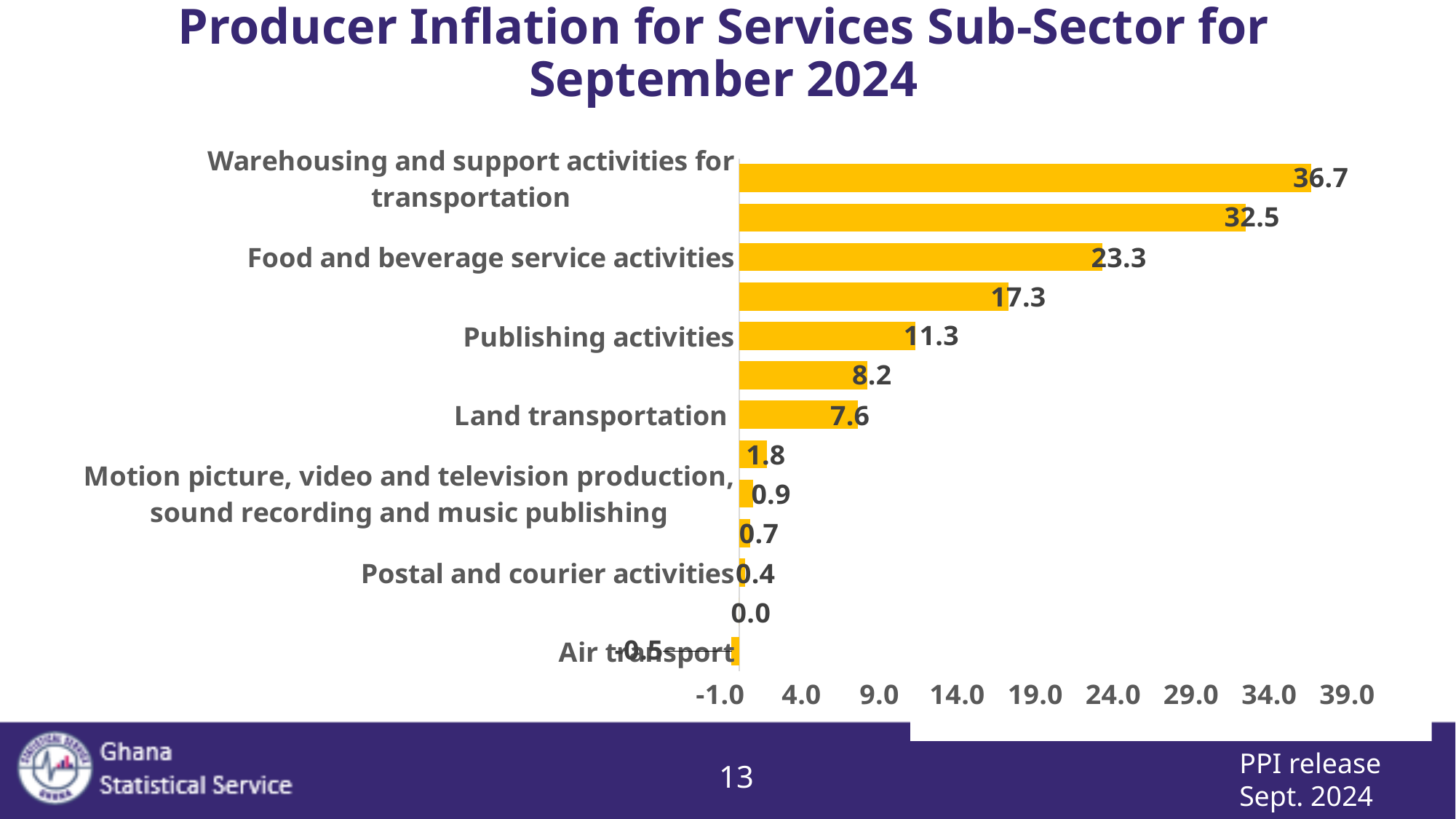
How many bars are plotted on the chart? 13 What is the value shown for Food and beverage service activities? 23.3 What is the difference between the values for Food and beverage service activities and Publishing activities? 12.0 What is the title of the chart? Producer Inflation for Services Sub-Sector for September 2024 Which sub-sector has the highest producer inflation on the chart? Warehousing and support activities for transportation What type of chart is shown on the slide? Bar chart What is the value shown for Postal and courier activities? 0.4 What is the producer inflation value for Warehousing and support activities for transportation? 36.7 What is the value shown for Publishing activities? 11.3 Which has a higher value: Land transportation or Motion picture, video and television production, sound recording and music publishing? Land transportation Which sub-sector has the lowest producer inflation on the chart? Air transport What is the value shown for Land transportation? 7.6